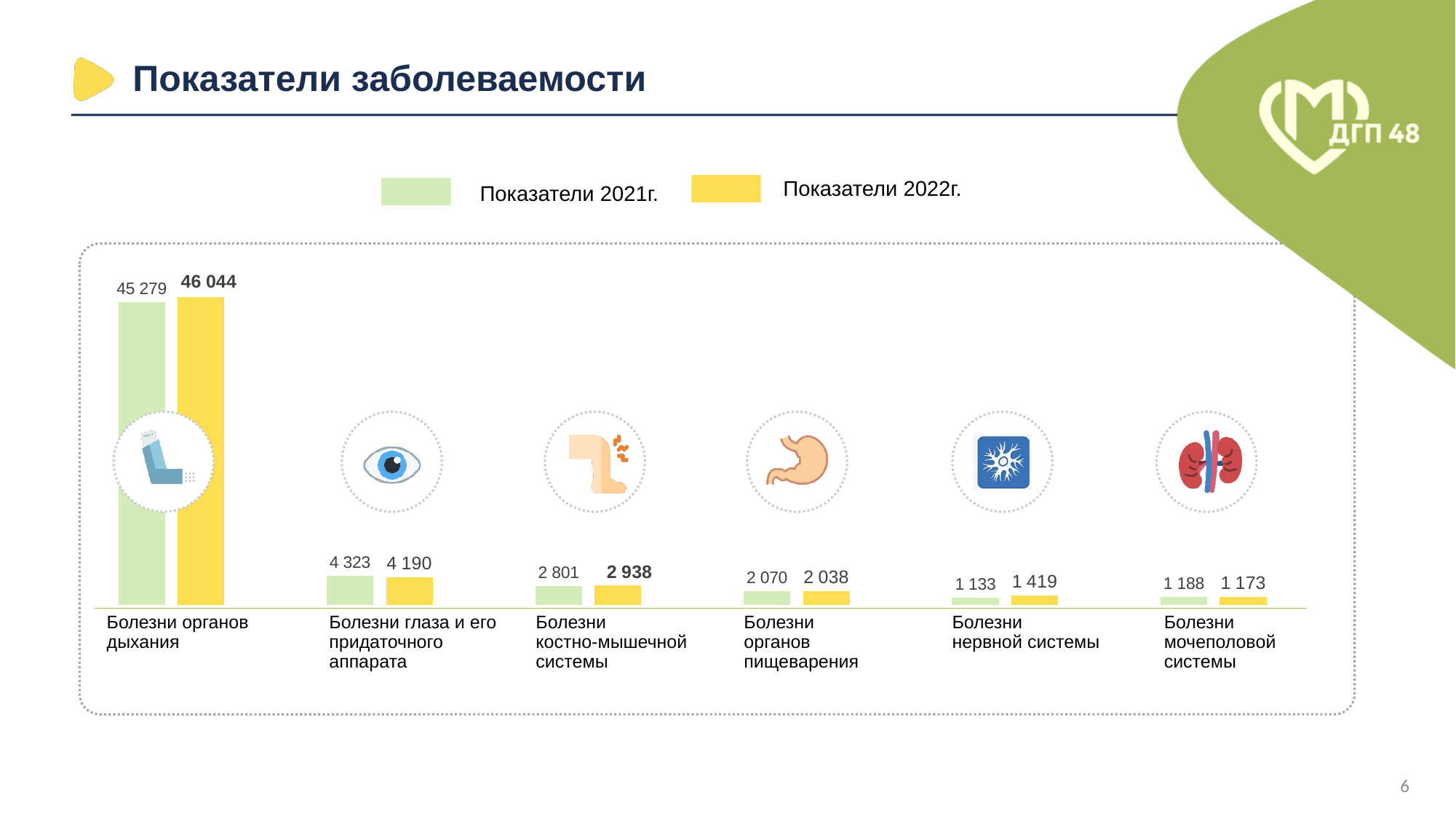
Which category has the lowest 2021 value? Болезни нервной системы What is the difference between the 2022 and 2021 values for Болезни нервной системы? 286 What is the difference between the 2022 and 2021 values for Болезни органов дыхания? 765 What is the 2022 value (Показатели 2022г.) for Болезни органов дыхания? 46 044 What type of chart is shown on the slide? Bar chart What is the 2021 value for Болезни мочеполовой системы? 1 188 What is the 2022 value for Болезни нервной системы? 1 419 How many disease categories are shown on the chart? 6 Which category has the highest 2022 value? Болезни органов дыхания What is the 2021 value (Показатели 2021г.) for Болезни глаза и его придаточного аппарата? 4 323 For Болезни костно-мышечной системы, which year has the larger value, 2021 or 2022? 2022 How many series does the legend list? 2